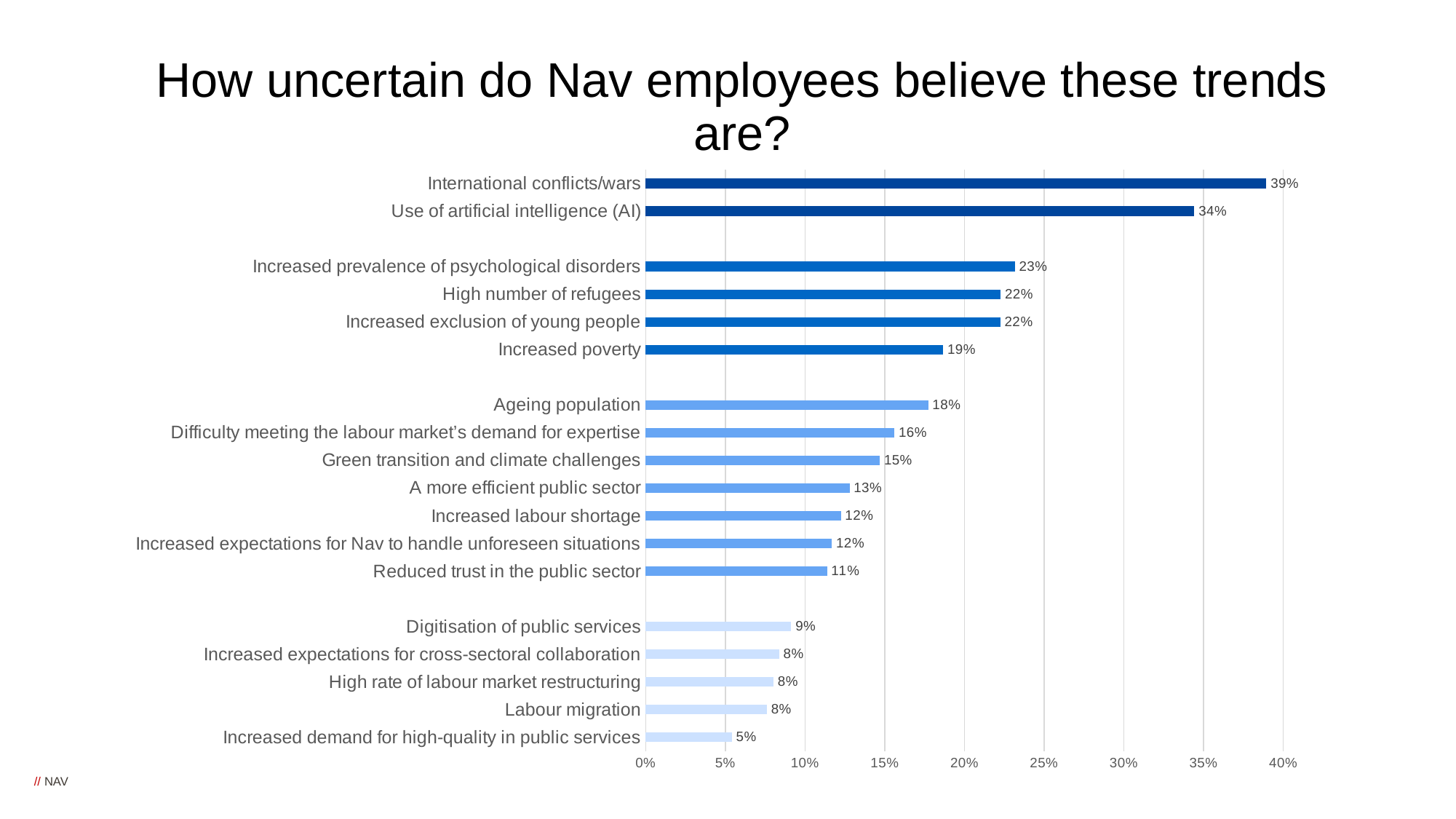
What is the value for Ageing population? 18% What is the title of the slide? How uncertain do Nav employees believe these trends are? Is the value for Increased prevalence of psychological disorders greater or less than 20%? greater Which trend has the highest value? International conflicts/wars What is the value for Use of artificial intelligence (AI)? 34% What is the value for Reduced trust in the public sector? 11% Which is larger, the value for Increased poverty or the value for Ageing population? Increased poverty What is the value for International conflicts/wars? 39% How many trends are plotted in the chart? 18 What is the difference between the values for International conflicts/wars and Use of artificial intelligence (AI)? 5% What kind of chart is shown on the slide? Bar chart Which trend has the lowest value? Increased demand for high-quality in public services